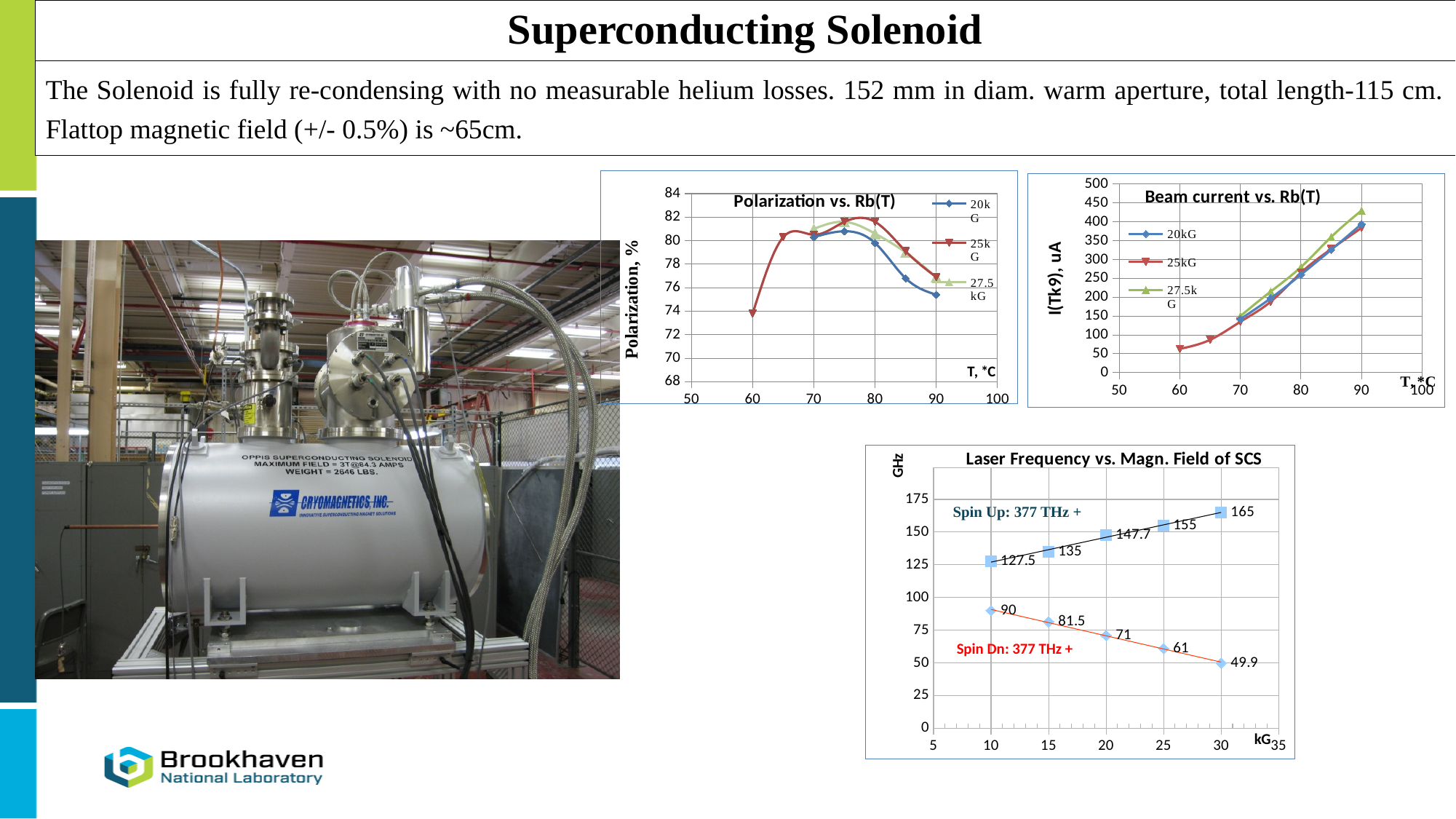
What kind of chart is the Beam current vs. Rb(T) chart? line chart In the Polarization vs. Rb(T) chart, is the 20kG value at 90 °C greater or less than 78? less In the Laser Frequency vs. Magn. Field of SCS chart, at which magnetic field is the Spin Up value highest? 30 kG In the Laser Frequency vs. Magn. Field of SCS chart, does the Spin Dn series rise or fall as the magnetic field increases? fall In the Laser Frequency vs. Magn. Field of SCS chart, what is the Spin Up value at 30 kG? 165 In the Laser Frequency vs. Magn. Field of SCS chart, what is the difference between the Spin Up and Spin Dn values at 20 kG? 76.7 In the Laser Frequency vs. Magn. Field of SCS chart, how many data points does the Spin Up series have? 5 In the Laser Frequency vs. Magn. Field of SCS chart, what is the Spin Dn value at 10 kG? 90 How many series does the legend of the Polarization vs. Rb(T) chart list? 3 In the Laser Frequency vs. Magn. Field of SCS chart, what is the Spin Dn value at 30 kG? 49.9 In the Laser Frequency vs. Magn. Field of SCS chart, does the Spin Up series rise or fall as the magnetic field increases? rise In the Beam current vs. Rb(T) chart, is the 25kG value at 60 °C greater or less than 100? less